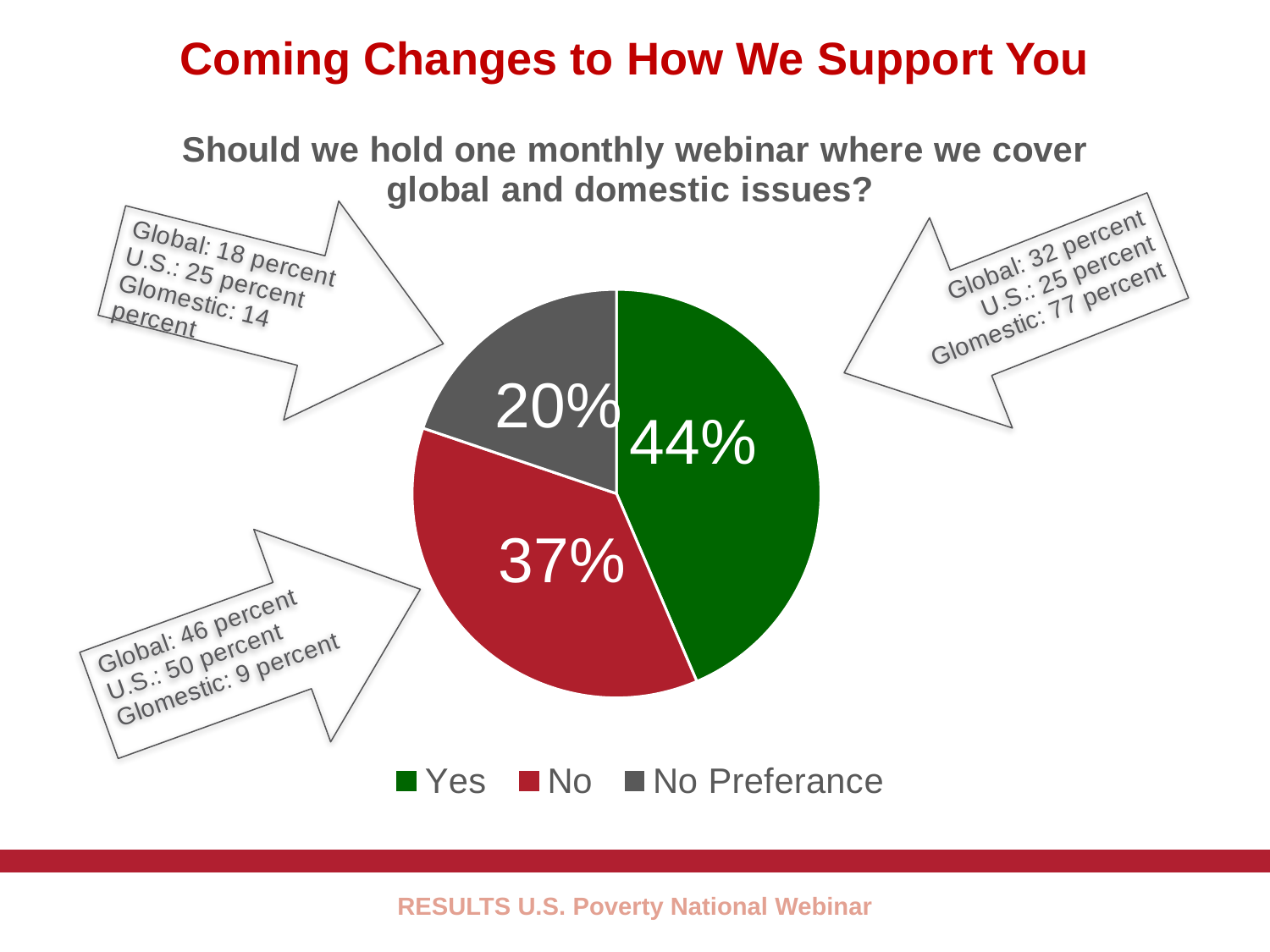
What colour is the Yes slice? green How many slices does the pie chart have? 3 What percentage of respondents answered No Preferance? 20% Which response has the smallest share of the pie? No Preferance Which is larger, the No slice or the No Preferance slice? No What percentage of respondents answered No? 37% What percentage of respondents answered Yes? 44% What is the difference in percentage points between the Yes and No slices? 7 What kind of chart is shown on the slide? pie chart Which response has the largest share of the pie? Yes How many entries does the legend list? 3 What question does the pie chart present responses to? Should we hold one monthly webinar where we cover global and domestic issues?